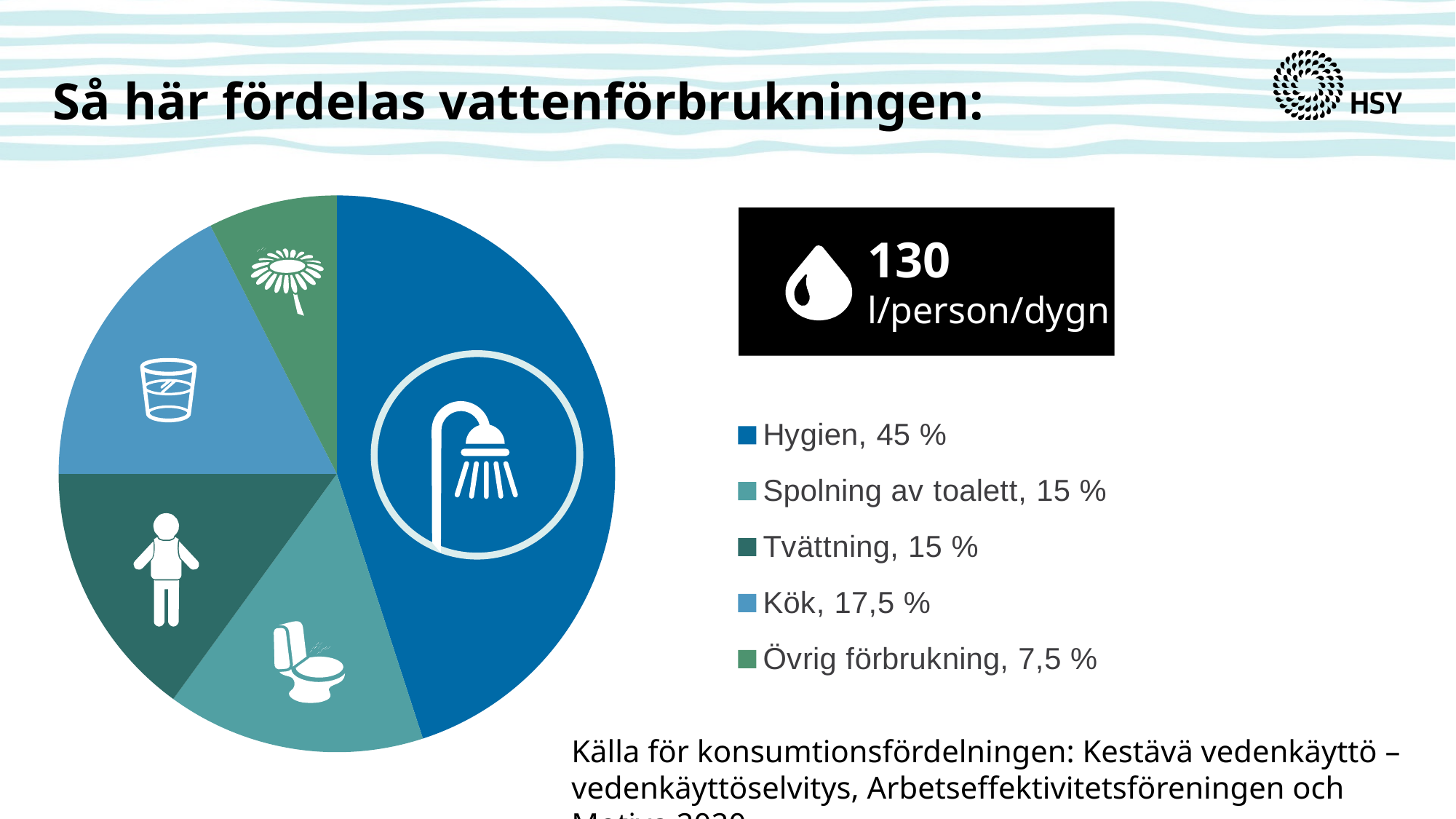
What is the difference in percentage points between Hygien and Kök? 27,5 % What percentage is shown for Kök? 17,5 % What share of water consumption does Hygien account for? 45 % Which category has the smallest share of the pie? Övrig förbrukning What is the combined share of Spolning av toalett and Tvättning? 30 % What percentage is shown for Spolning av toalett? 15 % Which is larger, the share for Kök or the share for Tvättning? Kök What kind of chart is shown on the slide? Pie chart What percentage is shown for Övrig förbrukning? 7,5 % How many categories does the pie chart have? 5 Which category has the largest share of the pie? Hygien What daily water consumption per person is stated on the slide? 130 l/person/dygn